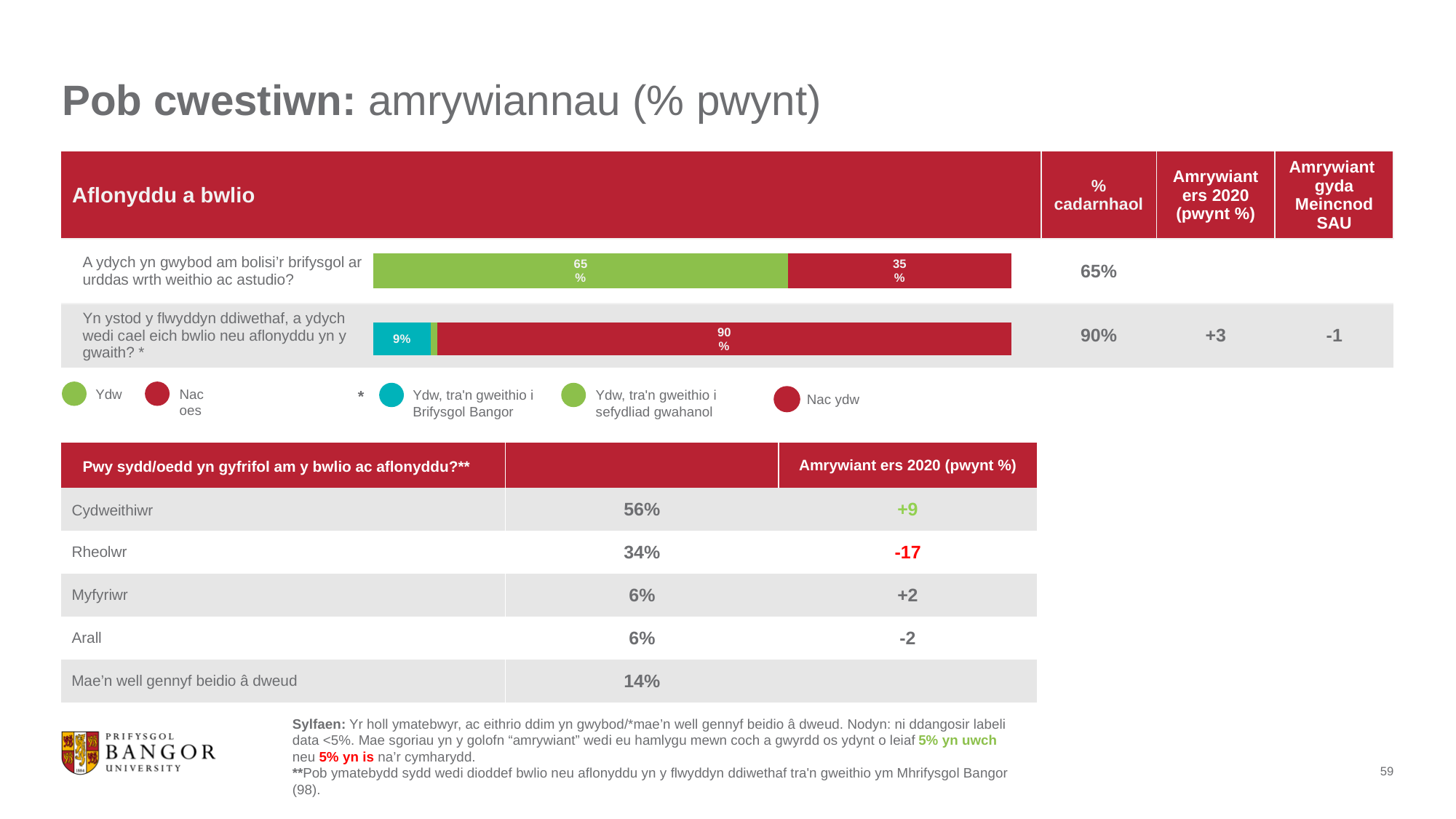
In the bar for 'A ydych yn gwybod am bolisi'r brifysgol ar urddas wrth weithio ac astudio?', what is the difference in percentage points between 'Ydw' and 'Nac oes'? 30 What colour represents 'Ydw, tra'n gweithio i Brifysgol Bangor' in the second bar? Teal In the bar for 'Yn ystod y flwyddyn ddiwethaf, a ydych wedi cael eich bwlio neu aflonyddu yn y gwaith?', which response has the largest share? Nac ydw In the bar for 'A ydych yn gwybod am bolisi'r brifysgol ar urddas wrth weithio ac astudio?', what percentage answered 'Nac oes'? 35% In the bar for 'Yn ystod y flwyddyn ddiwethaf, a ydych wedi cael eich bwlio neu aflonyddu yn y gwaith?', what percentage answered 'Ydw, tra'n gweithio i Brifysgol Bangor'? 9% What kind of chart is used to show the responses in the 'Aflonyddu a bwlio' section? Stacked bar chart How many response categories does the legend list for the second bar (marked with *)? 3 In the bar for 'Yn ystod y flwyddyn ddiwethaf, a ydych wedi cael eich bwlio neu aflonyddu yn y gwaith?', what percentage answered 'Nac ydw'? 90% In the bar for 'A ydych yn gwybod am bolisi'r brifysgol ar urddas wrth weithio ac astudio?', what percentage answered 'Ydw'? 65% Which is larger: the 'Nac oes' share in the first bar or the 'Ydw, tra'n gweithio i Brifysgol Bangor' share in the second bar? Nac oes in the first bar In the bar for 'Yn ystod y flwyddyn ddiwethaf, a ydych wedi cael eich bwlio neu aflonyddu yn y gwaith?', what is the difference in percentage points between 'Nac ydw' and 'Ydw, tra'n gweithio i Brifysgol Bangor'? 81 In the bar for 'A ydych yn gwybod am bolisi'r brifysgol ar urddas wrth weithio ac astudio?', which response has the larger share? Ydw